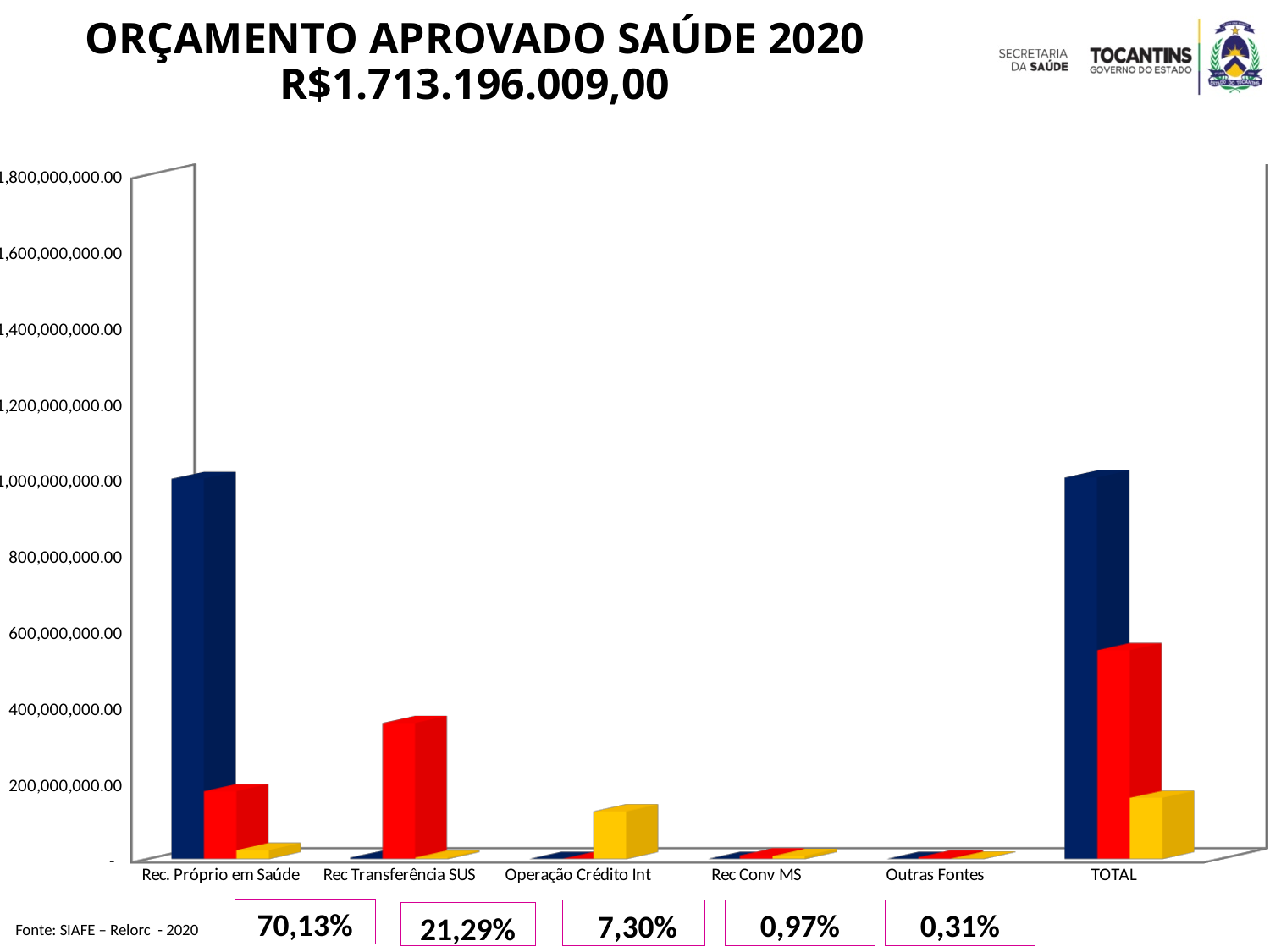
For Rec. Próprio em Saúde, which bar is taller, the dark blue one or the red one? the dark blue one Is the value of the red bar for Rec Transferência SUS greater or less than 200,000,000.00? greater Is the value of the yellow bar for Operação Crédito Int greater or less than 200,000,000.00? less Is the value of the red bar for TOTAL greater or less than 400,000,000.00? greater How many bars are plotted for each category in the chart? 3 What kind of chart is shown on the slide? bar chart What percentage is printed below the Rec. Próprio em Saúde category? 70,13% What is the title of the chart on the slide? ORÇAMENTO APROVADO SAÚDE 2020 R$1.713.196.009,00 Which category has the tallest red bar? TOTAL How many categories are shown on the x axis of the chart? 6